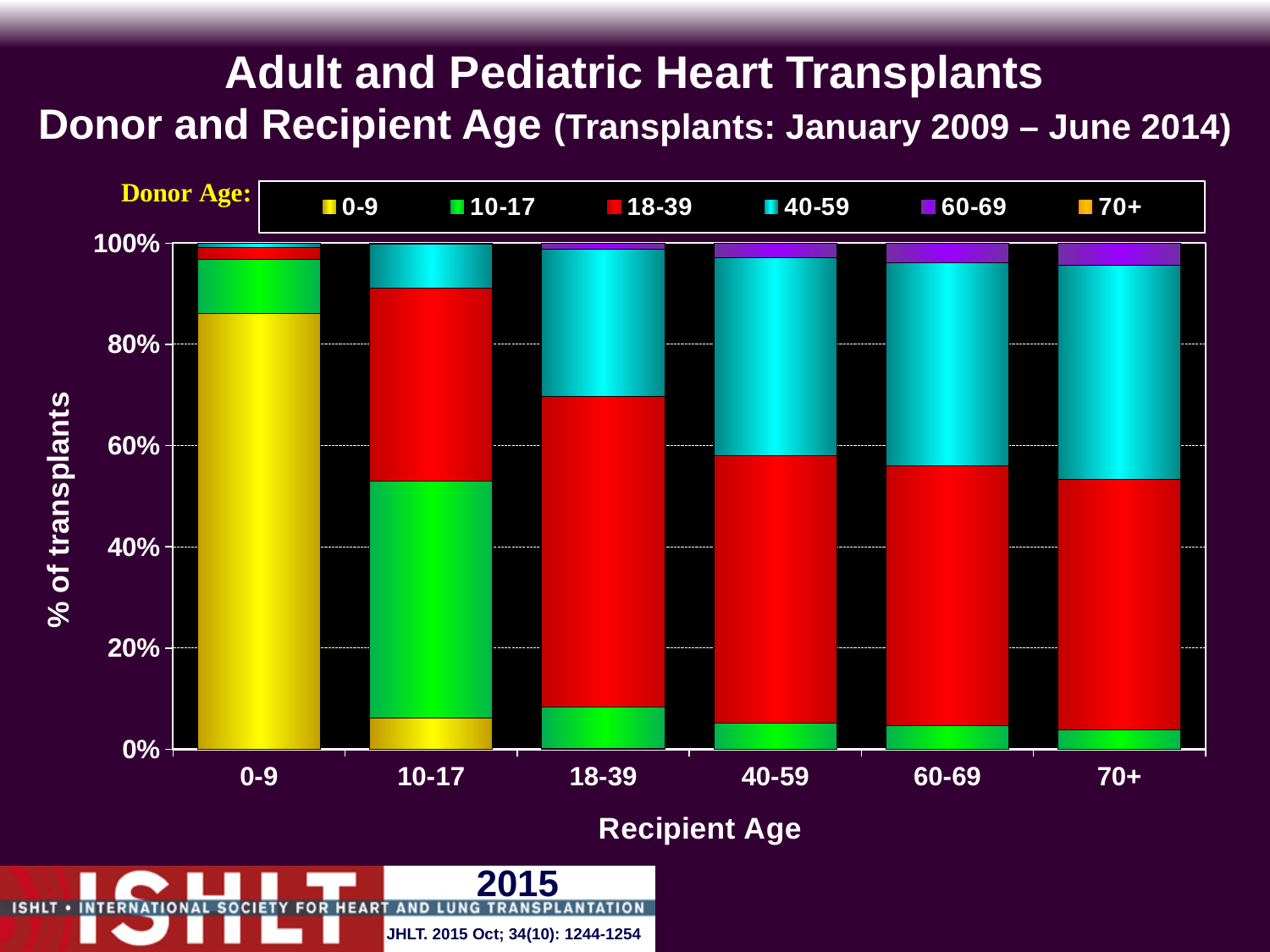
Which recipient age group has the largest share of transplants from donors aged 0-9? 0-9 What is the label of the y axis? % of transplants How many donor age groups does the legend list? 6 In the 18-39 recipient bar, does the boundary between the 18-39 and 40-59 donor segments lie above or below 60%? above What kind of chart is shown on the slide? Stacked bar chart For recipient age 0-9, is the share of transplants from donors aged 0-9 greater or less than 80%? greater Which recipient age group has the largest share of transplants from donors aged 18-39? 18-39 Which is larger: the share of transplants from donors aged 10-17 for recipient age 10-17, or for recipient age 18-39? Recipient age 10-17 What is the label of the x axis? Recipient Age In the 70+ recipient bar, does the boundary between the 18-39 and 40-59 donor segments lie above or below 60%? below How many recipient age groups are shown along the x axis? 6